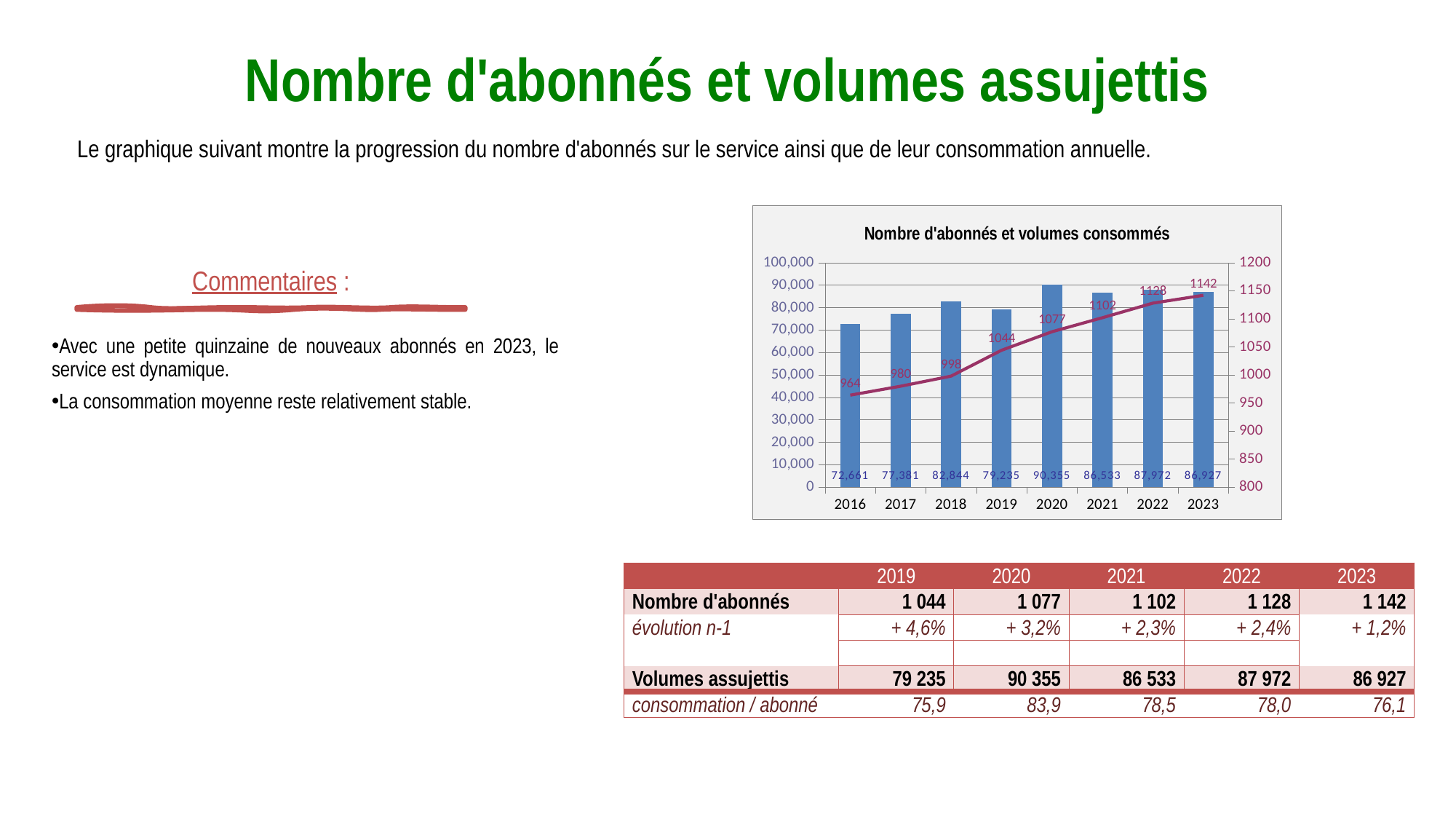
What is the value of the line data point for 2019? 1044 What is the value of the bar for 2020? 90,355 What kind of chart is shown on the slide? A combined bar and line chart How many years are shown on the x axis of the chart? 8 What is the difference between the bar values for 2020 and 2019? 11,120 Which year has the lowest bar value? 2016 What is the title of the chart? Nombre d'abonnés et volumes consommés What is the value of the bar for 2016? 72,661 Which year has the highest bar value? 2020 Does the line series rise or fall from 2016 to 2023? Rises Which is larger, the bar value for 2022 or for 2023? 2022 What is the value of the line data point for 2023? 1142